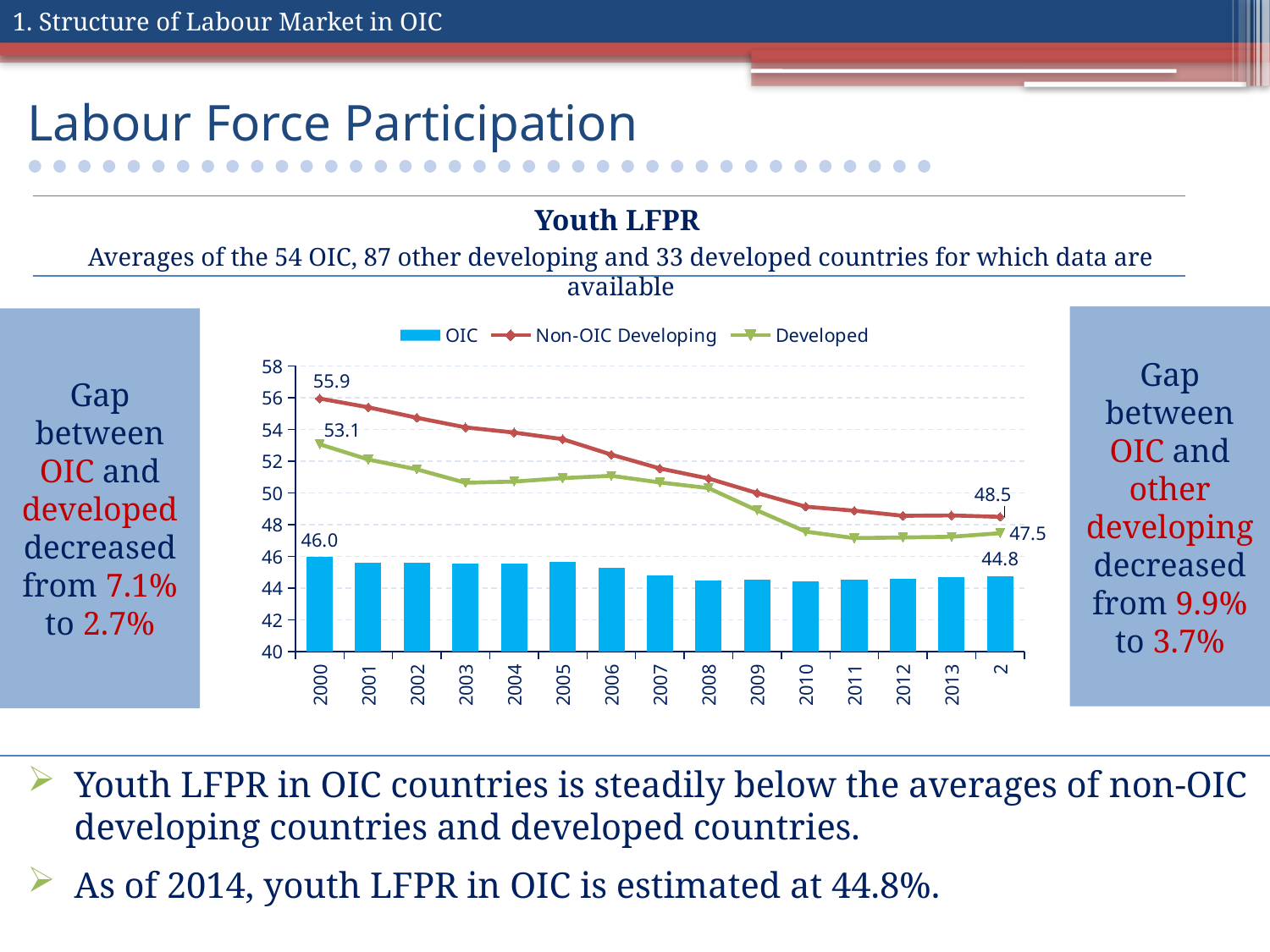
What is the Developed youth LFPR value shown for 2000? 53.1 What is the OIC youth LFPR value labelled for the final year shown (2014)? 44.8 In 2000, how much higher is the Non-OIC Developing value than the OIC value? 9.9 What is the Non-OIC Developing youth LFPR value shown for 2000? 55.9 Does the Non-OIC Developing line rise or fall from 2000 to the end of the period? fall In 2000, which is higher: Non-OIC Developing or Developed? Non-OIC Developing Is the OIC bar for 2010 greater or less than 46? less What is the OIC youth LFPR value labelled for 2000? 46.0 How many series does the legend list? 3 What is the Developed value labelled at the end of the series (2014)? 47.5 In 2000, how much higher is the Developed value than the OIC value? 7.1 What is the Non-OIC Developing value labelled at the end of the series (2014)? 48.5